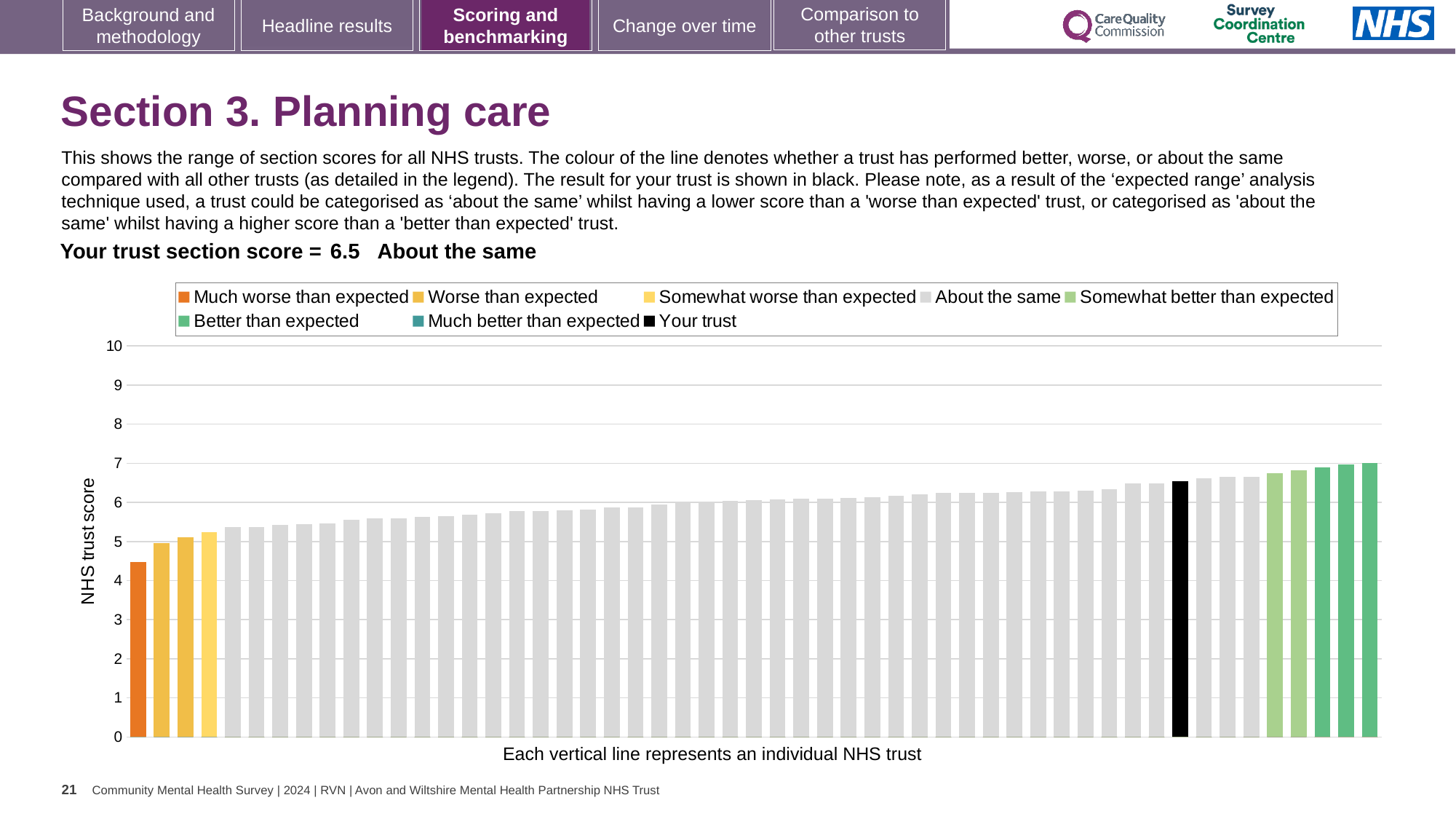
Is the value of the black 'Your trust' bar greater or less than 6? greater Do the bar values rise or fall from left to right along the x axis? rise Is the value of the lowest bar (the orange one) greater or less than 5? less How many bars are coloured orange ('Much worse than expected')? 1 Is the value of the highest bar greater or less than 6? greater What kind of chart is shown on the slide? bar chart How many entries does the chart legend list? 8 What colour is the bar representing your trust? black Which performance category is your trust placed in according to the slide? About the same What is the highest value shown on the y axis? 10 What is the section score for your trust shown on the slide? 6.5